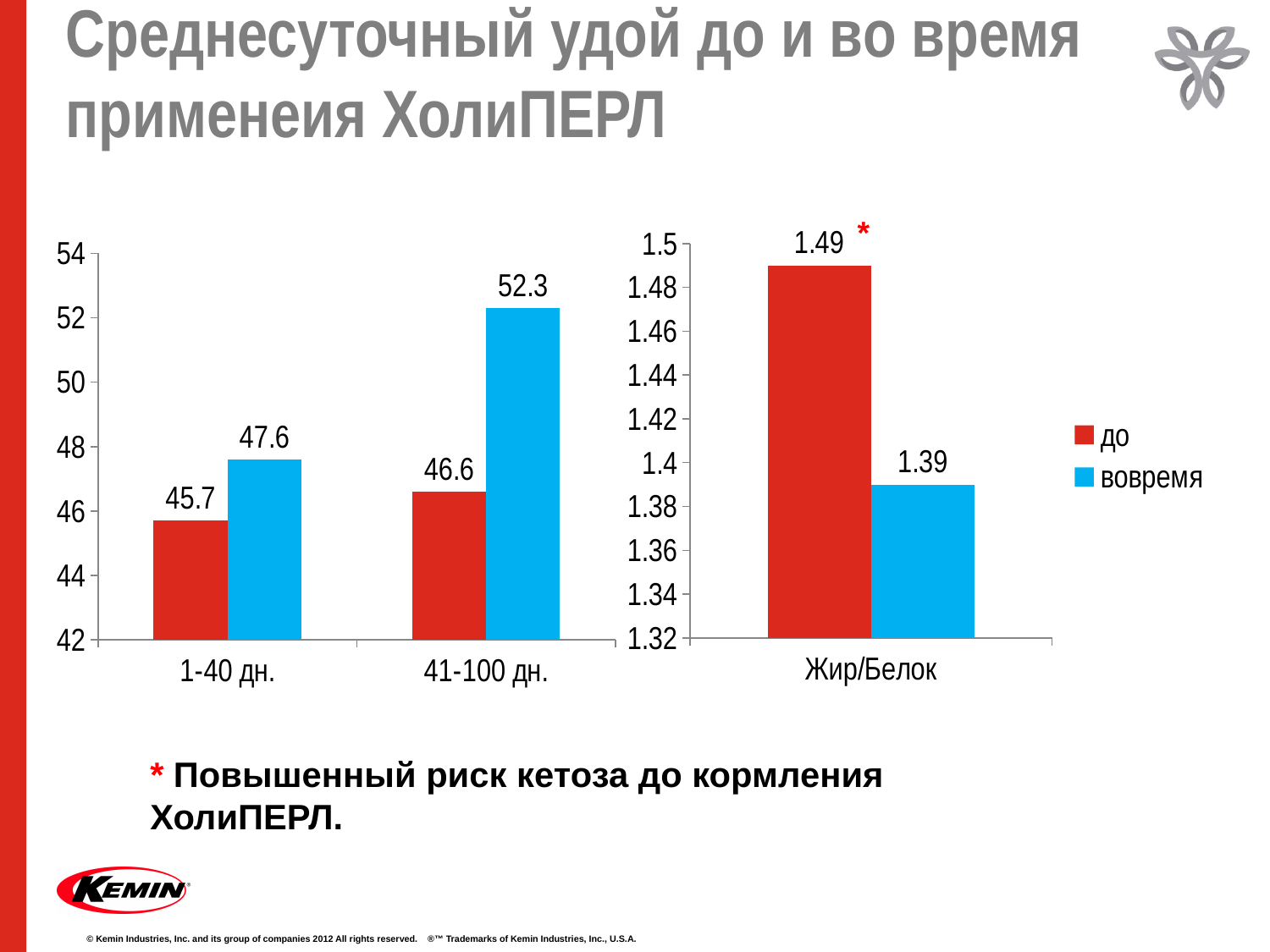
In the right chart, what is the difference between 'до' and 'вовремя' for 'Жир/Белок'? 0.1 In the left chart, which bar has the highest value? вовремя, 41-100 дн. In the left chart, what is the difference between 'вовремя' and 'до' in the '41-100 дн.' category? 5.7 In the right chart, what is the value for 'до' for 'Жир/Белок'? 1.49 In the left chart, which is larger for '1-40 дн.': 'до' or 'вовремя'? вовремя In the left chart, what is the value for 'до' in the '1-40 дн.' category? 45.7 How many series does the legend list? 2 In the left chart, which bar has the lowest value? до, 1-40 дн. In the left chart, what is the value for 'вовремя' in the '41-100 дн.' category? 52.3 In the right chart, what is the value for 'вовремя' for 'Жир/Белок'? 1.39 How many categories are shown on the x axis of the left chart? 2 In the right chart, is the value for 'вовремя' greater or less than 1.4? less